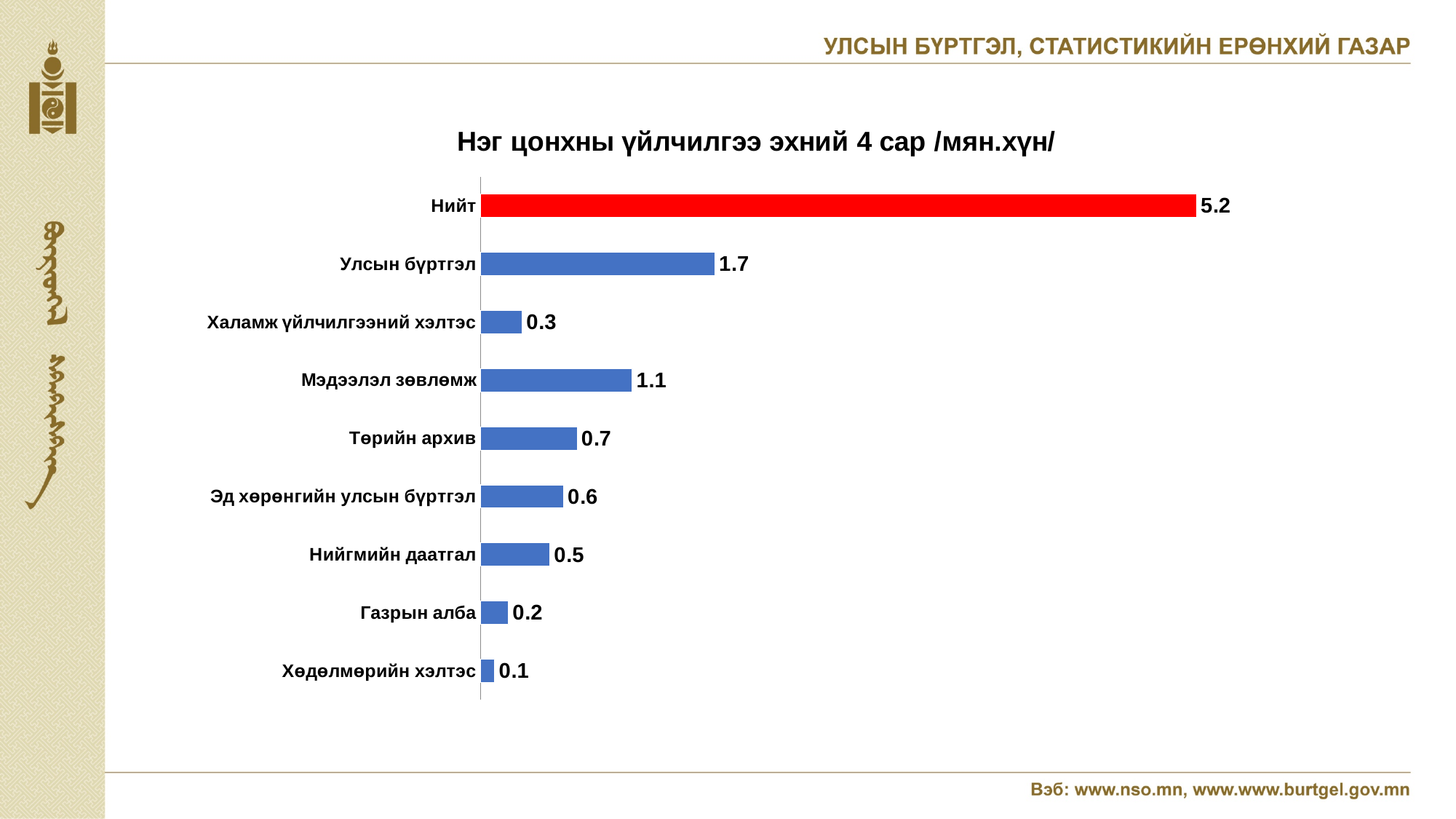
What is the title of the chart? Нэг цонхны үйлчилгээ эхний 4 сар /мян.хүн/ What is the value for Нийт? 5.2 How many bars are shown in the chart? 9 Which category has the lowest value? Хөдөлмөрийн хэлтэс What kind of chart is shown on the slide? Bar chart Excluding the Нийт total bar, which category has the highest value? Улсын бүртгэл What is the value for Улсын бүртгэл? 1.7 Which bar is coloured red? Нийт Which is larger, the value for Эд хөрөнгийн улсын бүртгэл or the value for Нийгмийн даатгал? Эд хөрөнгийн улсын бүртгэл What is the difference between the values for Улсын бүртгэл and Мэдээлэл зөвлөмж? 0.6 What is the value for Төрийн архив? 0.7 What is the value for Мэдээлэл зөвлөмж? 1.1